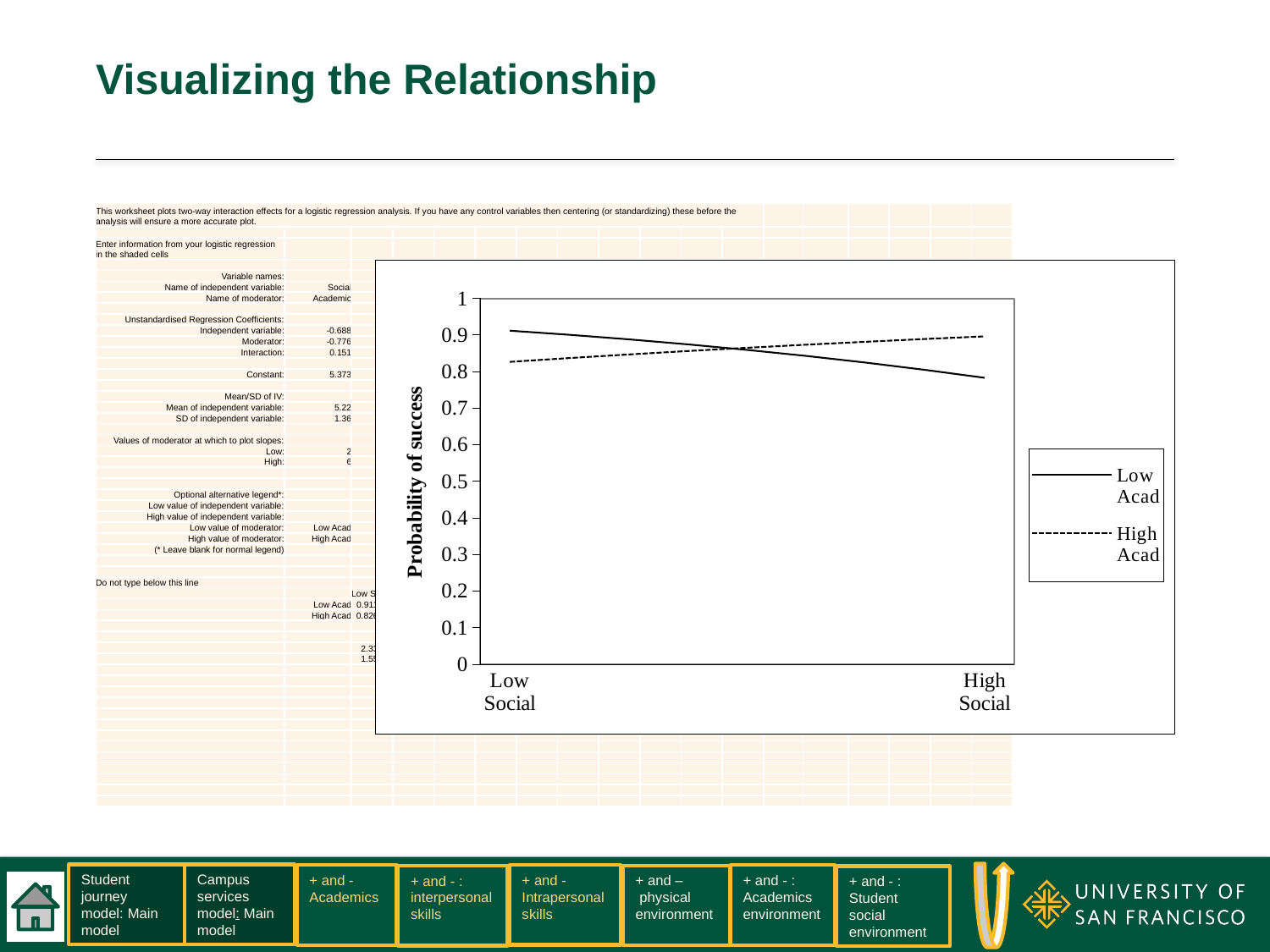
How many categories are shown on the x axis of the chart? 2 At Low Social, which series has the higher probability of success, Low Acad or High Acad? Low Acad What is the title of the y axis of the chart? Probability of success At High Social, which series has the higher probability of success, Low Acad or High Acad? High Acad How many series does the chart's legend list? 2 Is the value for High Acad at Low Social greater or less than 0.9? less Is the value for Low Acad at Low Social greater or less than 0.8? greater Is the value for Low Acad at High Social greater or less than 0.9? less Does the High Acad line rise or fall from Low Social to High Social? rise Does the Low Acad line rise or fall from Low Social to High Social? fall Which series is drawn with a dashed line in the chart? High Acad What kind of chart is shown on the slide? line chart